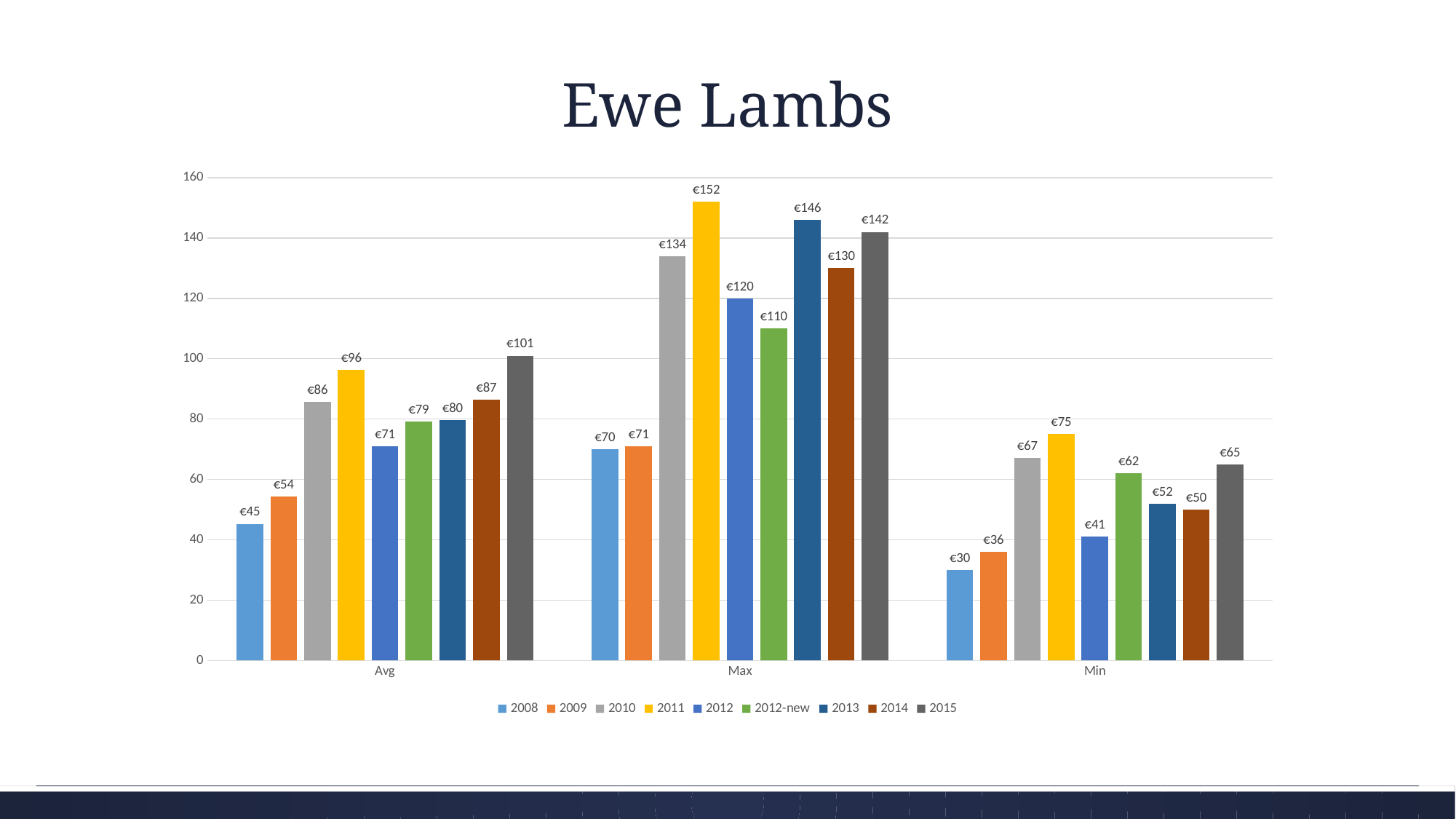
What is the Min value for 2008? €30 How many series does the legend list? 9 Which series has the lowest Avg value? 2008 What is the Max value for 2013? €146 Is the Avg value for 2015 greater or less than 100? greater Which is larger, the Min value for 2010 or the Min value for 2015? 2010 What kind of chart is shown on the slide? bar chart What is the Avg value for 2011? €96 How many categories are shown on the x axis? 3 What is the difference between the Max values for 2011 and 2012-new? €42 What is the title of the chart? Ewe Lambs Which series has the highest Max value? 2011